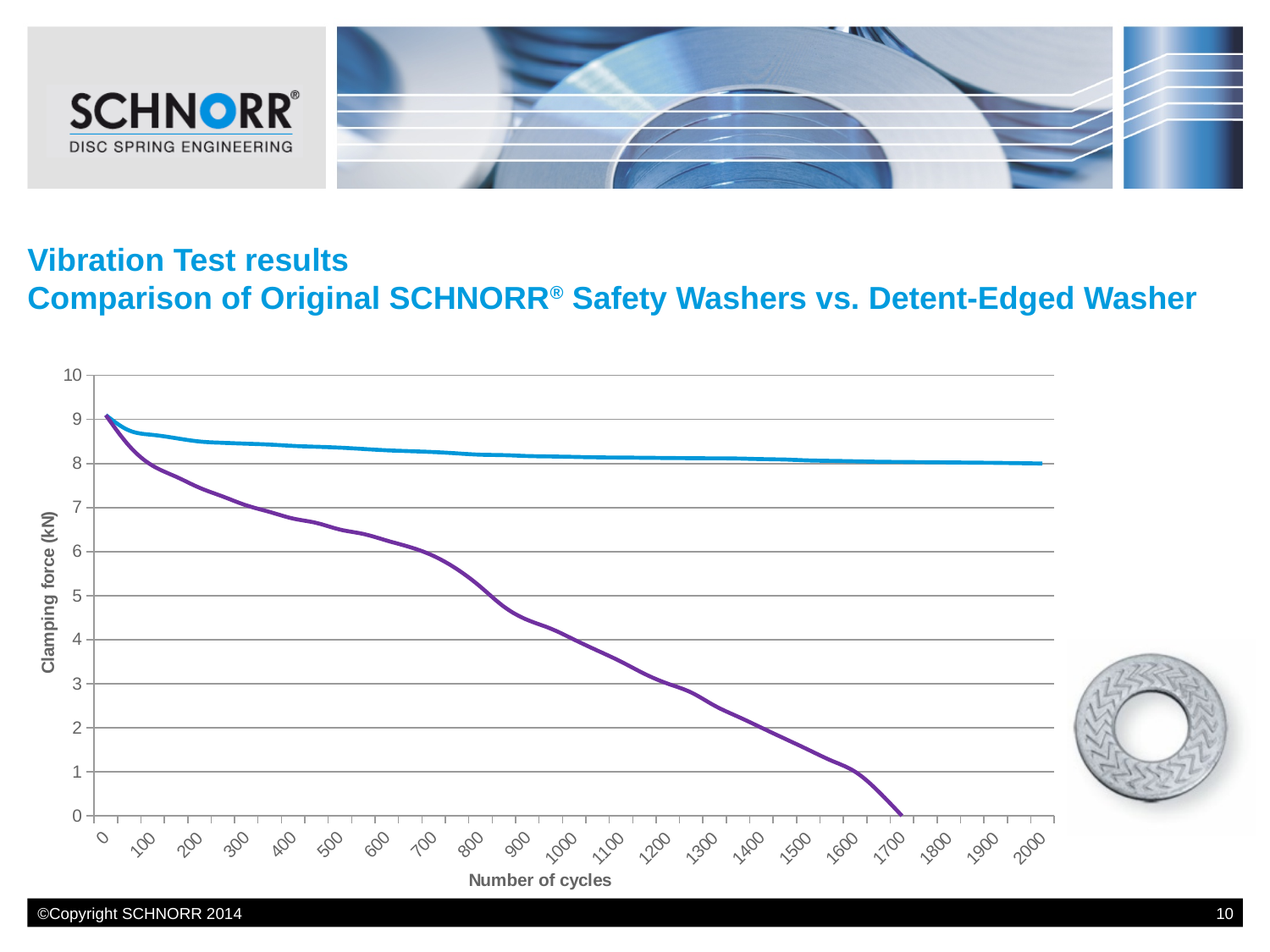
Does the purple line rise or fall as the number of cycles increases? fall What is the title of the vertical axis of the chart? Clamping force (kN) What kind of chart is shown on the slide? line chart Does the blue line rise or fall as the number of cycles increases? fall Is the clamping force of the purple line at 500 cycles greater or less than 6 kN? greater What is the title of the horizontal axis of the chart? Number of cycles Is the number of cycles at which the purple line reaches 0 kN greater or less than 1800? less Is the clamping force of the blue line at 2000 cycles greater or less than 9 kN? less How many lines are plotted on the chart? 2 At 1000 cycles, which line shows the higher clamping force, the blue line or the purple line? blue line